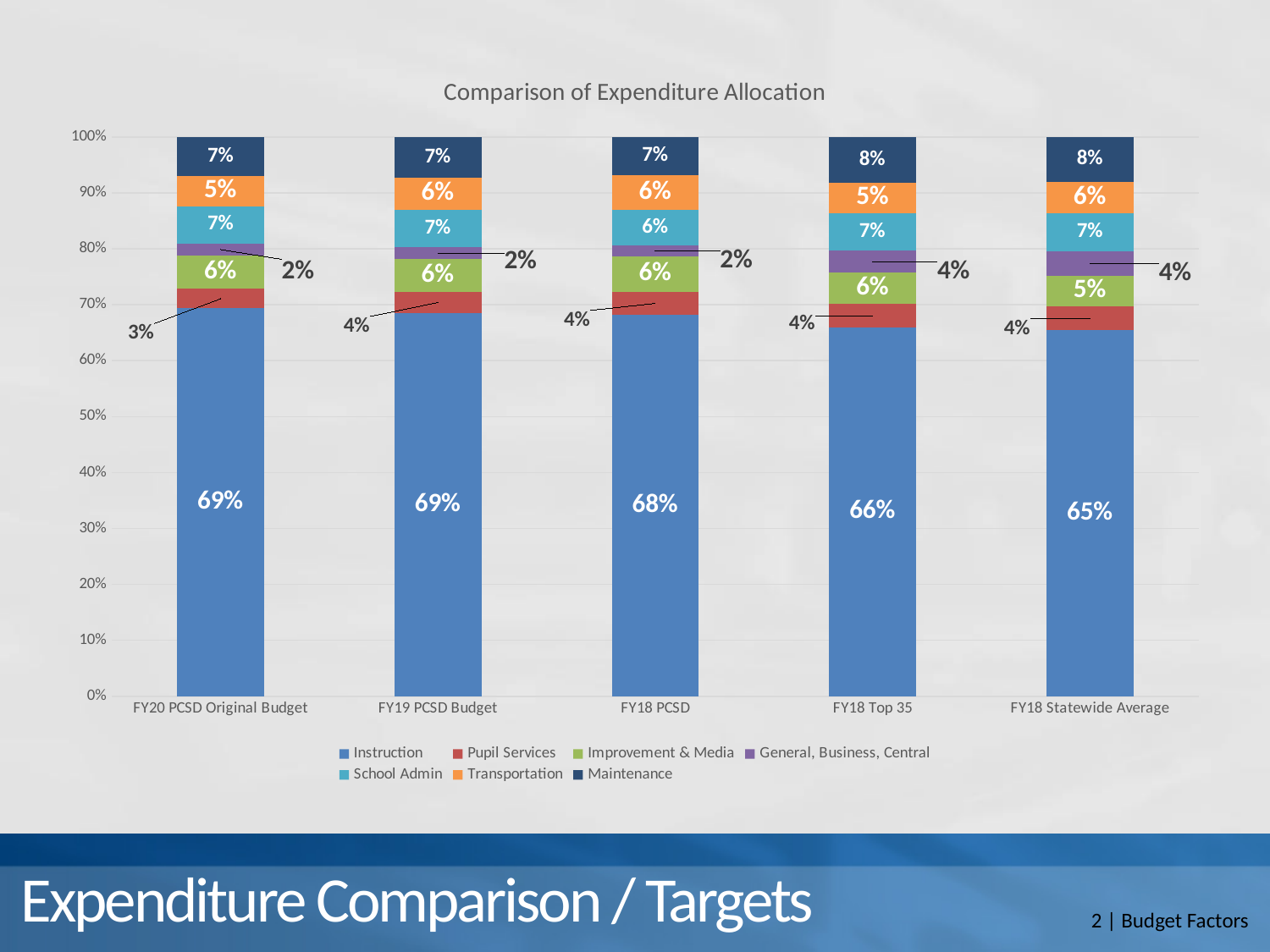
What is the Pupil Services share for FY20 PCSD Original Budget? 3% How many series does the legend list? 7 What is the difference between the Instruction share for FY19 PCSD Budget and FY18 Top 35? 3% What is the Maintenance share for FY18 Top 35? 8% What is the Instruction share for FY18 Statewide Average? 65% What kind of chart is shown on the slide? Stacked bar chart Does the Instruction share rise or fall moving from FY20 PCSD Original Budget to FY18 Statewide Average along the x axis? Fall What is the Instruction share for FY20 PCSD Original Budget? 69% How many categories are shown along the x axis? 5 What is the chart's title? Comparison of Expenditure Allocation Which is larger, the General, Business, Central share for FY18 PCSD or for FY18 Top 35? FY18 Top 35 Which category has the lowest Instruction share? FY18 Statewide Average